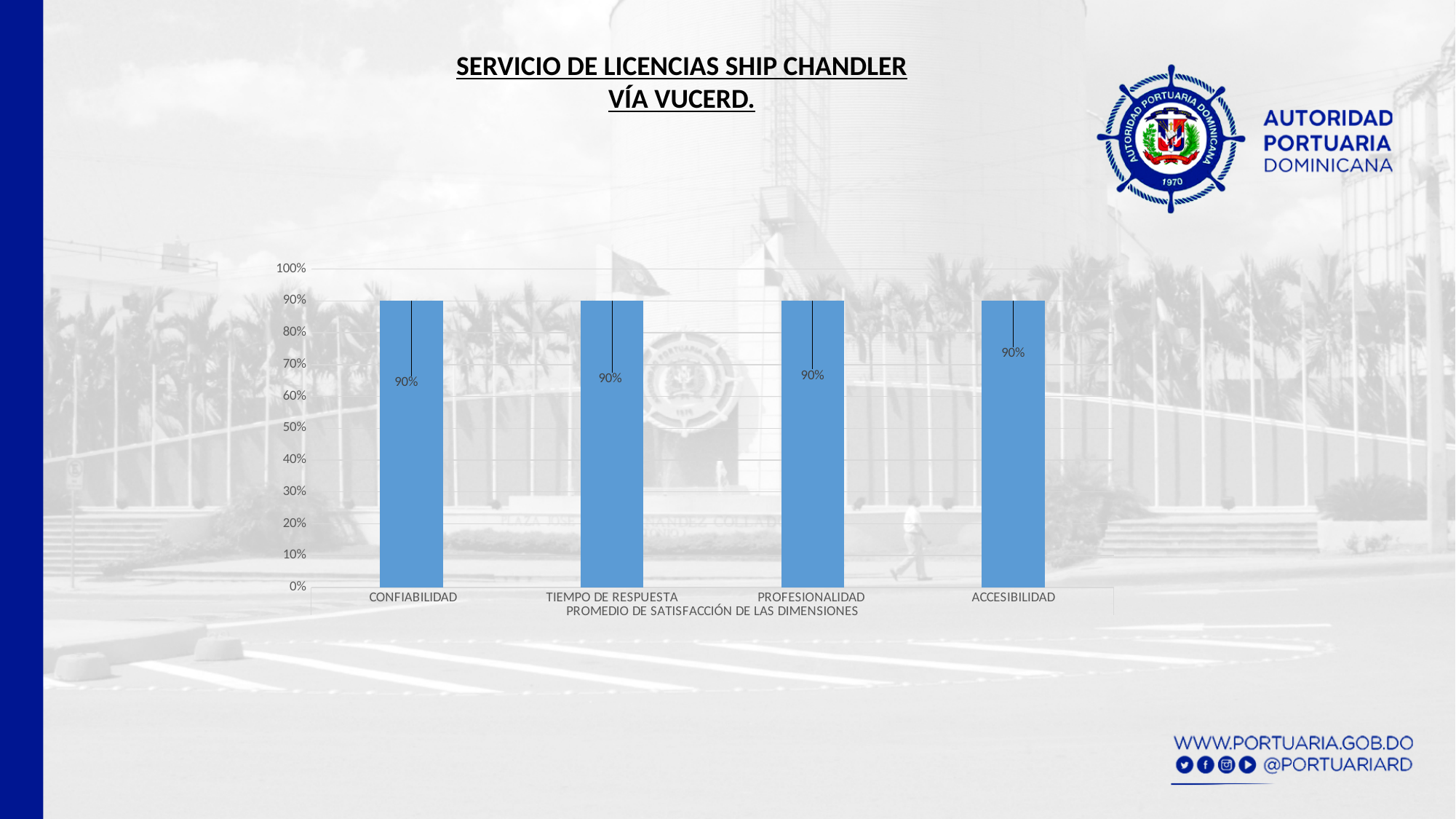
What is the title of the slide? SERVICIO DE LICENCIAS SHIP CHANDLER VÍA VUCERD. What is the value for TIEMPO DE RESPUESTA? 90% What is the value for ACCESIBILIDAD? 90% What is the difference between the values for CONFIABILIDAD and ACCESIBILIDAD? 0% Is the value for TIEMPO DE RESPUESTA greater or less than 100%? less What is the value for PROFESIONALIDAD? 90% How many categories are shown on the x axis? 4 What is the x-axis title of the chart? PROMEDIO DE SATISFACCIÓN DE LAS DIMENSIONES Do the values rise, fall or stay the same across the categories from left to right? Stay the same What kind of chart is shown on the slide? Bar chart What is the value for CONFIABILIDAD? 90% Is the value for PROFESIONALIDAD greater or less than 50%? greater